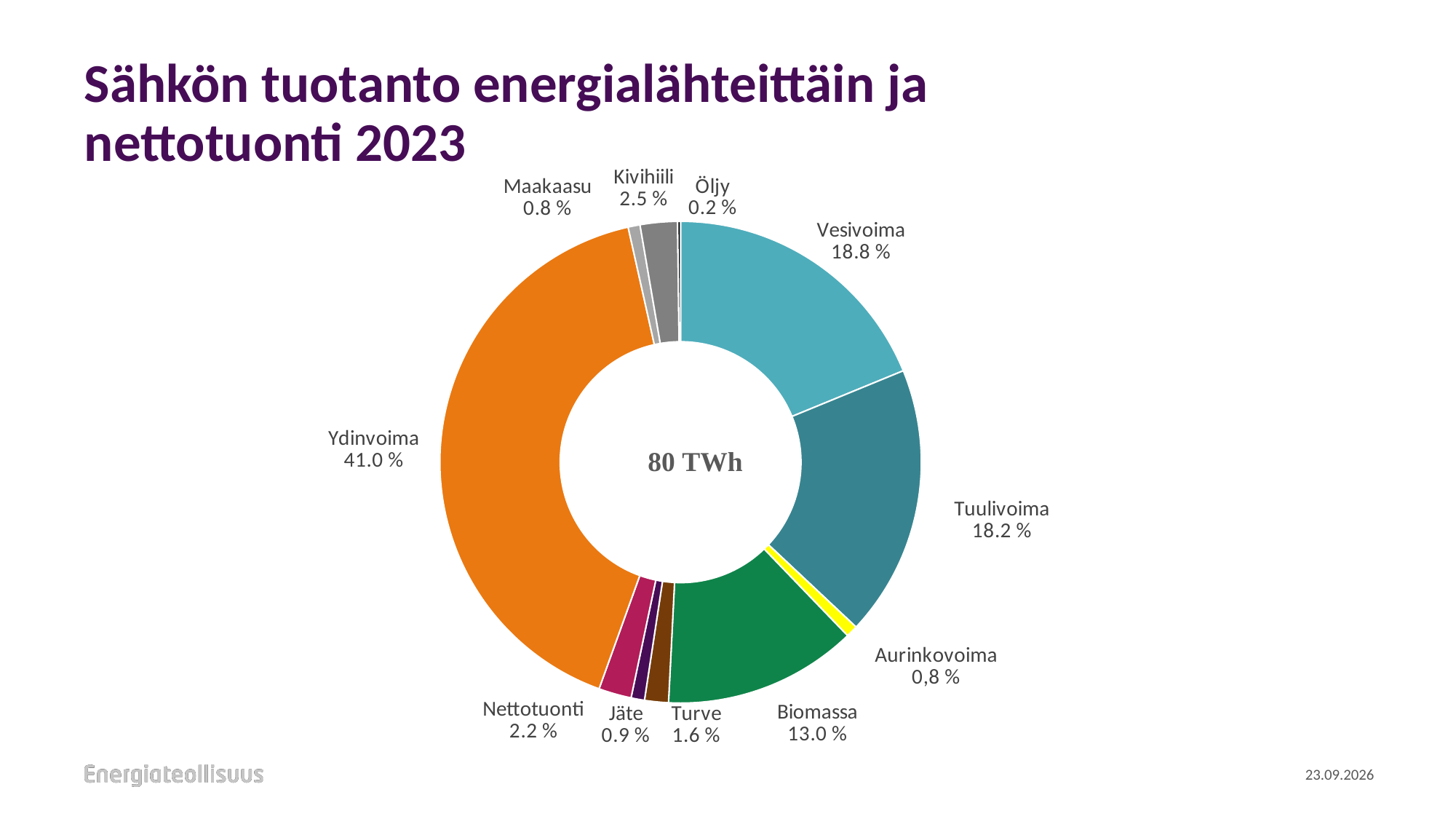
What share does Nettotuonti have in the chart? 2.2 % What total value is printed in the centre of the chart? 80 TWh How many categories are shown in the chart? 11 Which category has the smallest share in the chart? Öljy Which has a larger share, Kivihiili or Turve? Kivihiili What kind of chart is shown on the slide? Pie (donut) chart What is the difference in percentage points between Vesivoima and Tuulivoima? 0.6 What is the title of the chart on the slide? Sähkön tuotanto energialähteittäin ja nettotuonti 2023 What share does Vesivoima have in the chart? 18.8 % Which category has the largest share in the chart? Ydinvoima What share does Ydinvoima have in the chart? 41.0 % What share does Biomassa have in the chart? 13.0 %